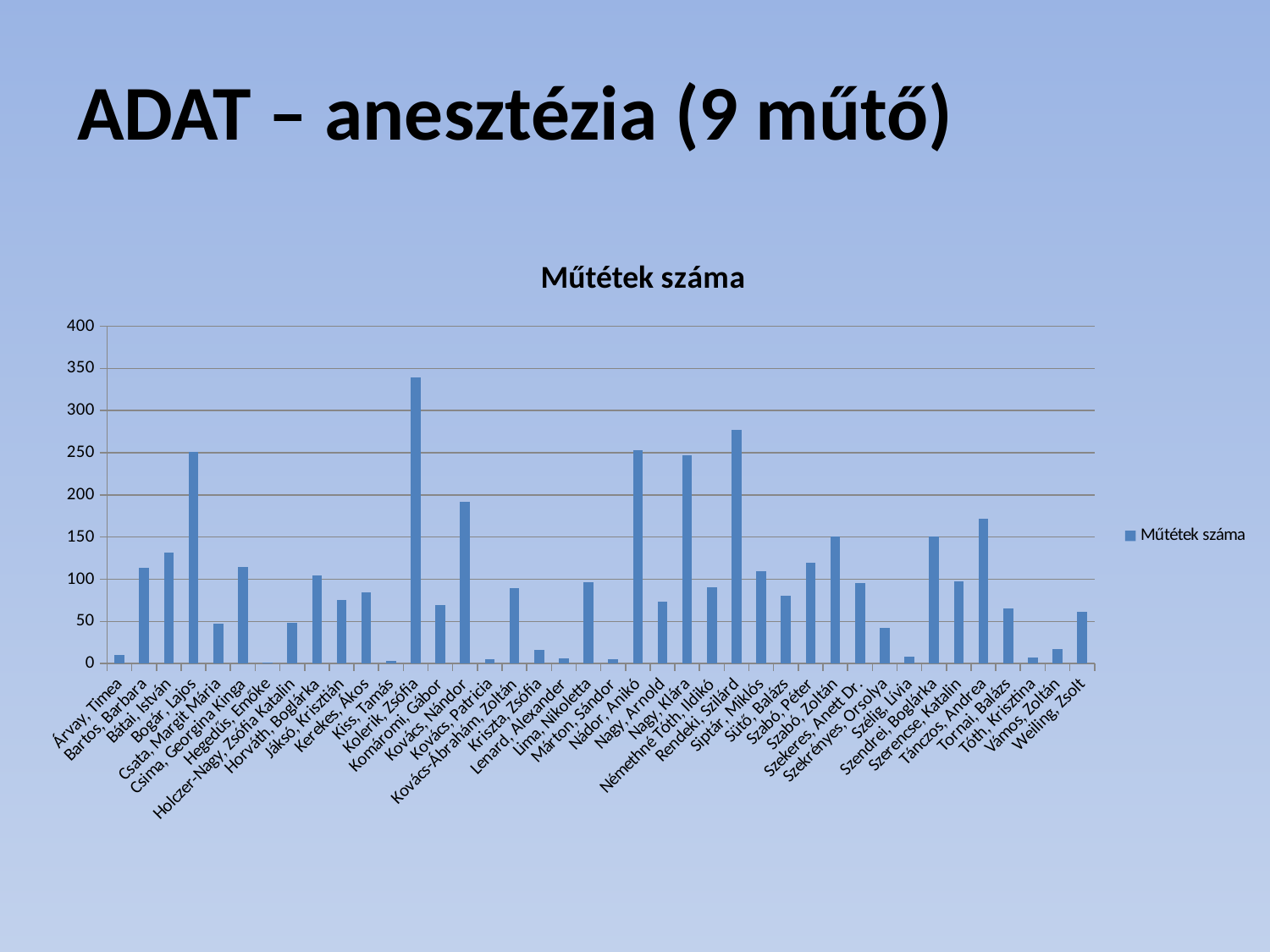
Is the value for Rendeki, Szilárd greater or less than 250? greater Which is larger, the value for Kovács, Nándor or the value for Tánczos, Andrea? Kovács, Nándor Is the value for Kerekes, Ákos greater or less than 100? less What is the title of the chart? Műtétek száma How many categories (names) are shown on the x axis? 40 Is the value for Tánczos, Andrea greater or less than 150? greater What type of chart is shown on the slide? bar chart How many series does the legend list? 1 Which category has the highest value? Kolerik, Zsófia Which is larger, the value for Kolerik, Zsófia or the value for Rendeki, Szilárd? Kolerik, Zsófia